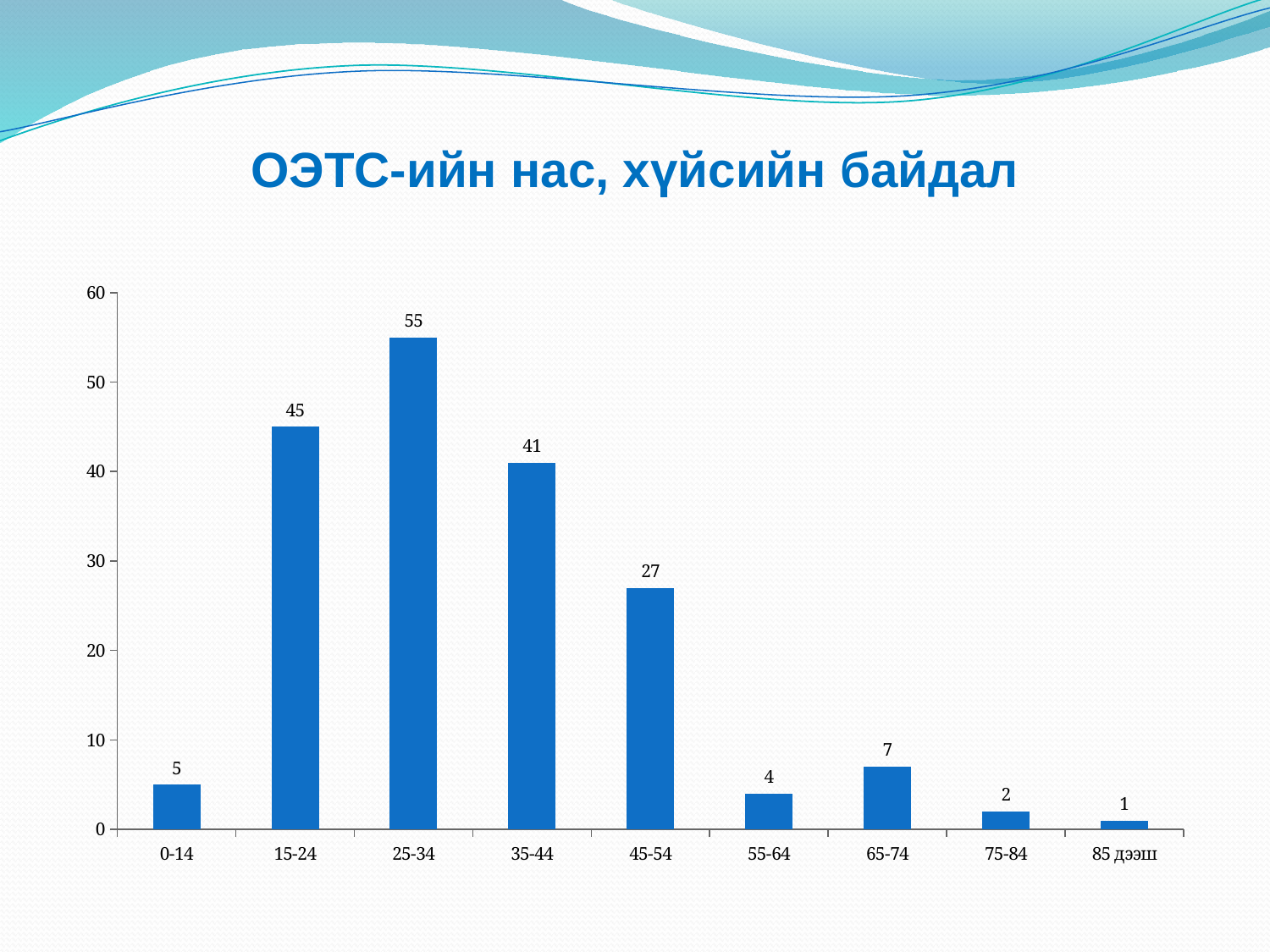
What is the value for the 45-54 age group? 27 Is the value for 35-44 greater or less than 40? greater What is the value for the 0-14 age group? 5 What is the value for the 25-34 age group? 55 Which age group has the lowest value? 85 дээш What is the difference between the values for 25-34 and 45-54? 28 What is the difference between the values for 15-24 and 35-44? 4 How many age groups are shown on the x axis? 9 What is the title of the slide? ОЭТС-ийн нас, хүйсийн байдал Which age group has the highest value? 25-34 What kind of chart is shown on the slide? bar chart Which is larger, the value for 55-64 or the value for 65-74? 65-74